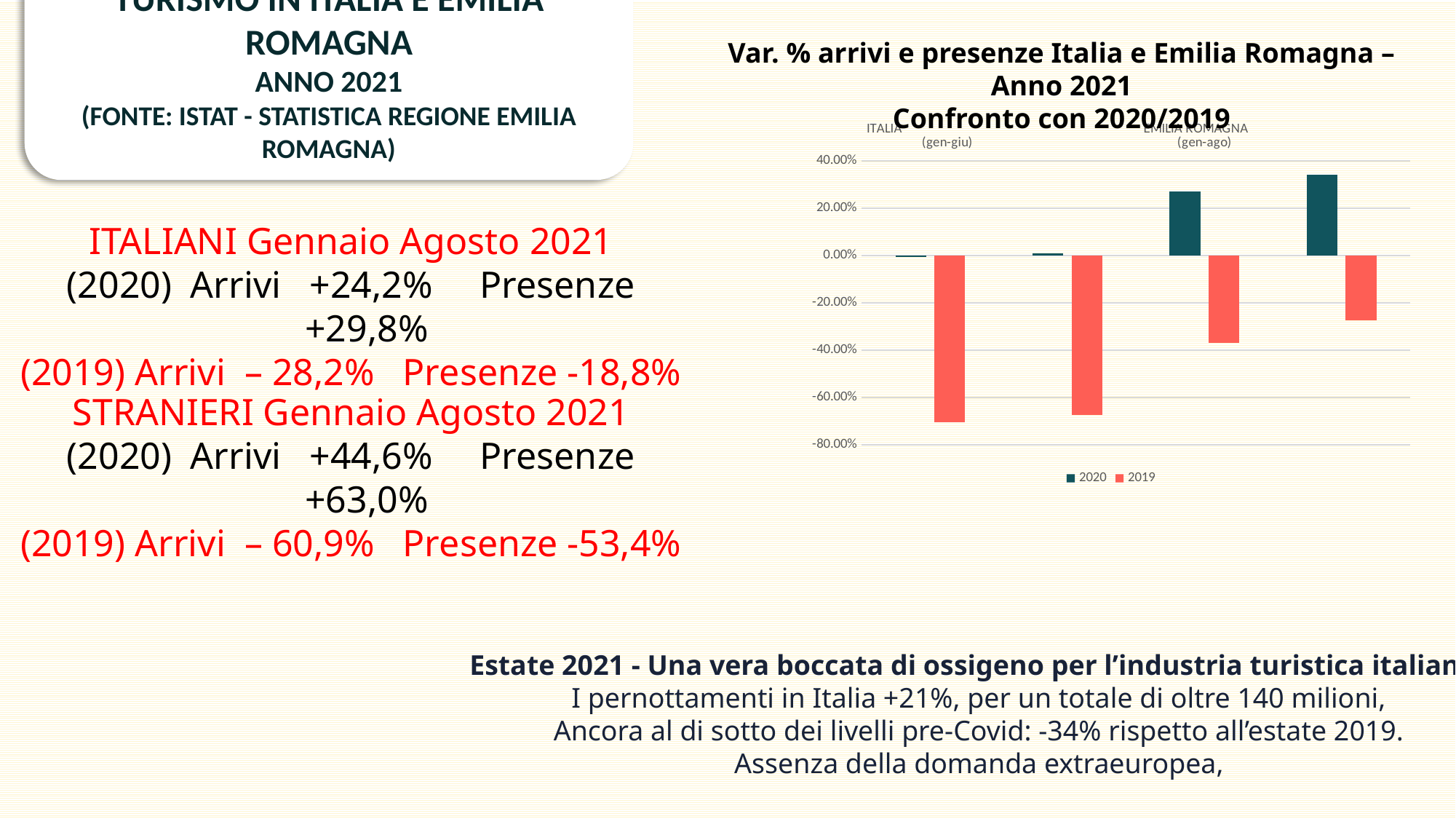
How many groups of bars are plotted in the chart? 4 What kind of chart is shown on the slide? bar chart Which series has all of its bars below 0.00%? 2019 Is the value of the leftmost 2019 bar (first group under ITALIA) greater or less than -60%? less What are the two series named in the chart legend? 2020 and 2019 Is the value of the rightmost 2020 bar (last group under EMILIA ROMAGNA) greater or less than 20%? greater Which section of the chart has the higher 2020 bars, ITALIA (gen-giu) or EMILIA ROMAGNA (gen-ago)? EMILIA ROMAGNA (gen-ago) Which series has the highest bar in the chart, 2020 or 2019? 2020 Is the value of the 2019 bar in the third group (first group under EMILIA ROMAGNA) greater or less than -20%? less How many series does the chart legend list? 2 Which 2020 bar is taller: the one in the third group or the one in the fourth (rightmost) group? the fourth (rightmost) group